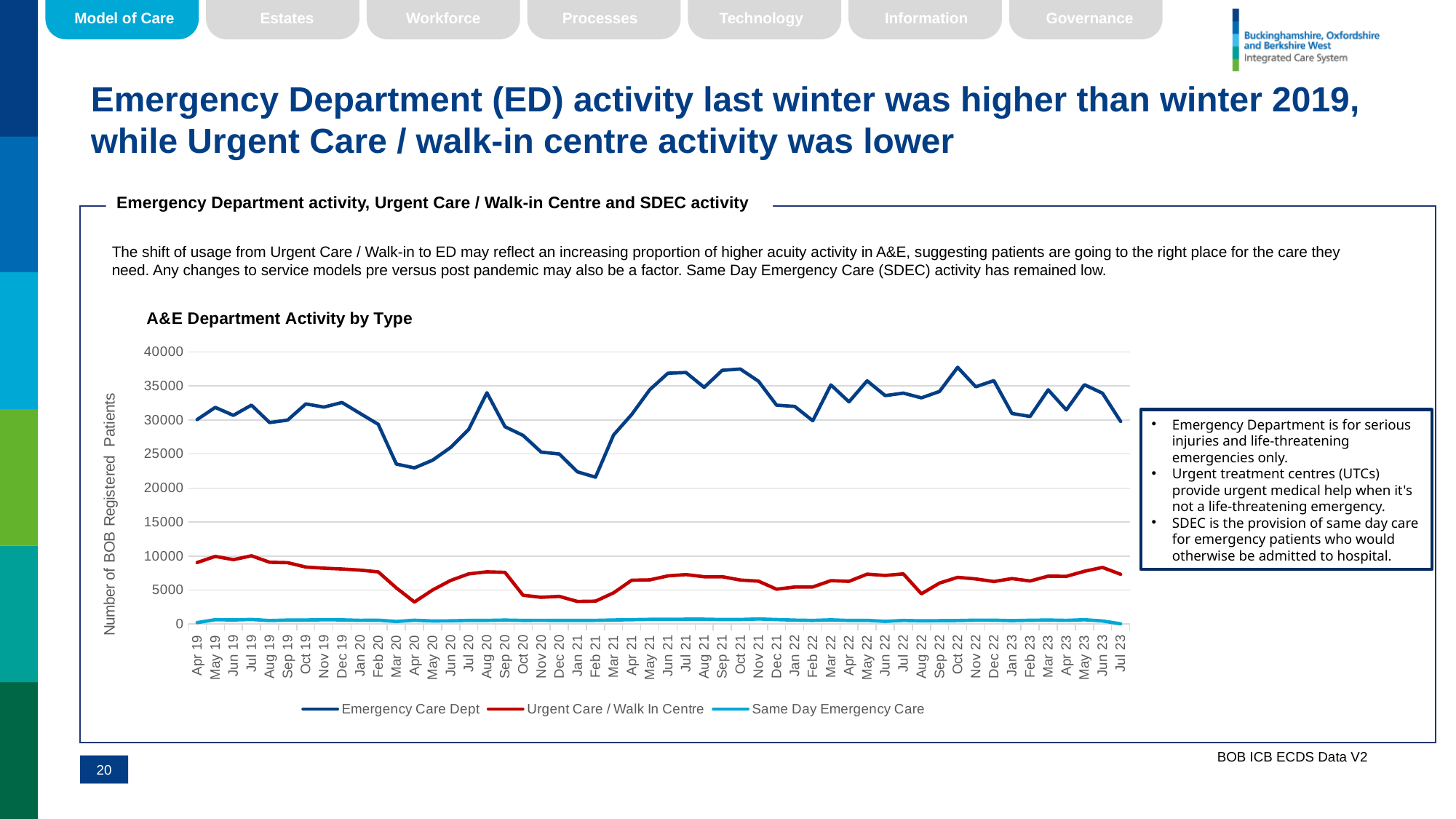
What is the label on the vertical axis of the 'A&E Department Activity by Type' chart? Number of BOB Registered Patients Is the value for Urgent Care / Walk In Centre in Apr 20 greater or less than 5000? less How many months are plotted along the x axis of the 'A&E Department Activity by Type' chart? 52 In Jul 23, which is larger: Emergency Care Dept or Urgent Care / Walk In Centre? Emergency Care Dept What is the title of the chart on the slide? A&E Department Activity by Type Which series has the lowest values throughout the 'A&E Department Activity by Type' chart? Same Day Emergency Care How many series does the legend of the 'A&E Department Activity by Type' chart list? 3 Is the value for Urgent Care / Walk In Centre in Apr 19 greater or less than 5000? greater In which month does the Emergency Care Dept series reach its lowest point? Feb 21 Is the value for Emergency Care Dept in Feb 21 greater or less than 25000? less What kind of chart is the 'A&E Department Activity by Type' chart? line chart